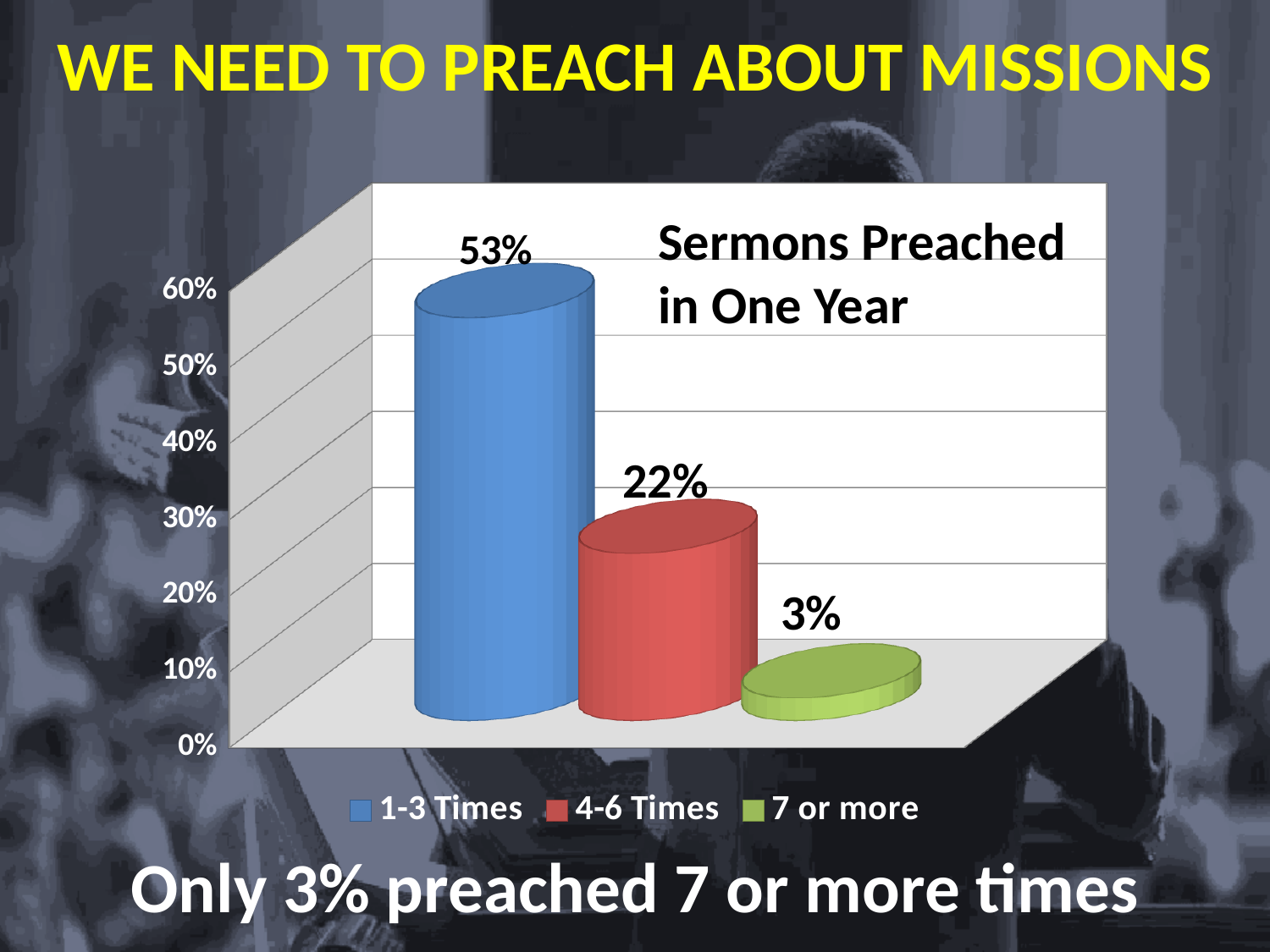
What percentage is shown for 1-3 Times? 53% Is the value for 1-3 Times greater or less than 50%? greater What kind of chart is shown on the slide? Bar chart What is the difference between the values for 1-3 Times and 4-6 Times? 31% What is the difference between the values for 4-6 Times and 7 or more? 19% Which category has the lowest value? 7 or more How many categories does the chart show? 3 Which is larger, the value for 4-6 Times or the value for 7 or more? 4-6 Times Which category has the highest value? 1-3 Times What is the title of the chart? Sermons Preached in One Year What percentage is shown for 7 or more? 3% What percentage is shown for 4-6 Times? 22%